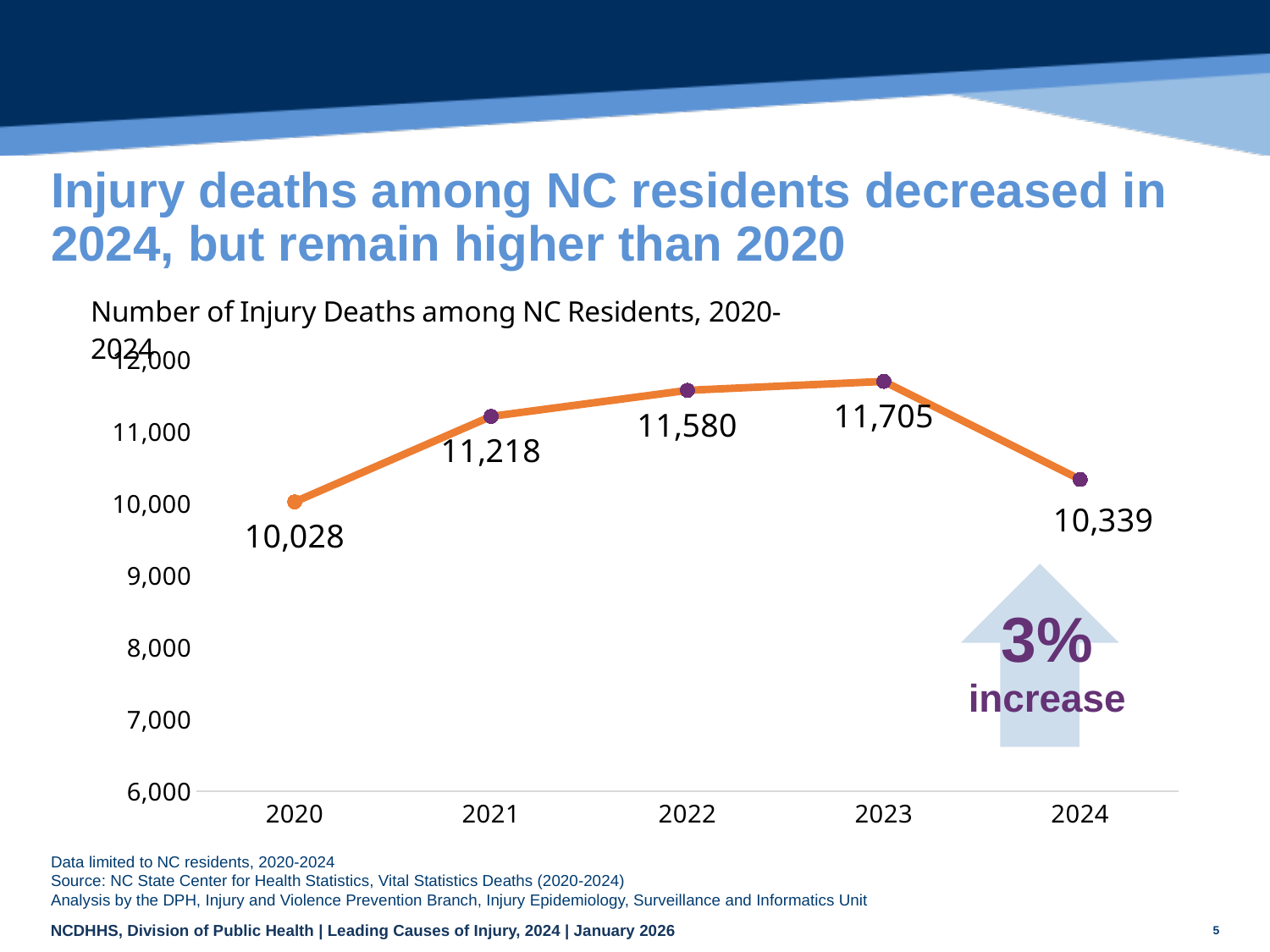
What type of chart is shown on the slide? Line chart What is the title of the chart? Number of Injury Deaths among NC Residents, 2020-2024 Which year had the lowest number of injury deaths? 2020 What is the difference in injury deaths between 2024 and 2020? 311 Which year had more injury deaths, 2021 or 2022? 2022 Did injury deaths rise or fall from 2020 to 2023? Rise What was the number of injury deaths among NC residents in 2023? 11,705 What is the difference in injury deaths between 2023 and 2024? 1,366 How many years are plotted on the chart? 5 What was the number of injury deaths among NC residents in 2024? 10,339 What was the number of injury deaths among NC residents in 2020? 10,028 Which year had the highest number of injury deaths? 2023